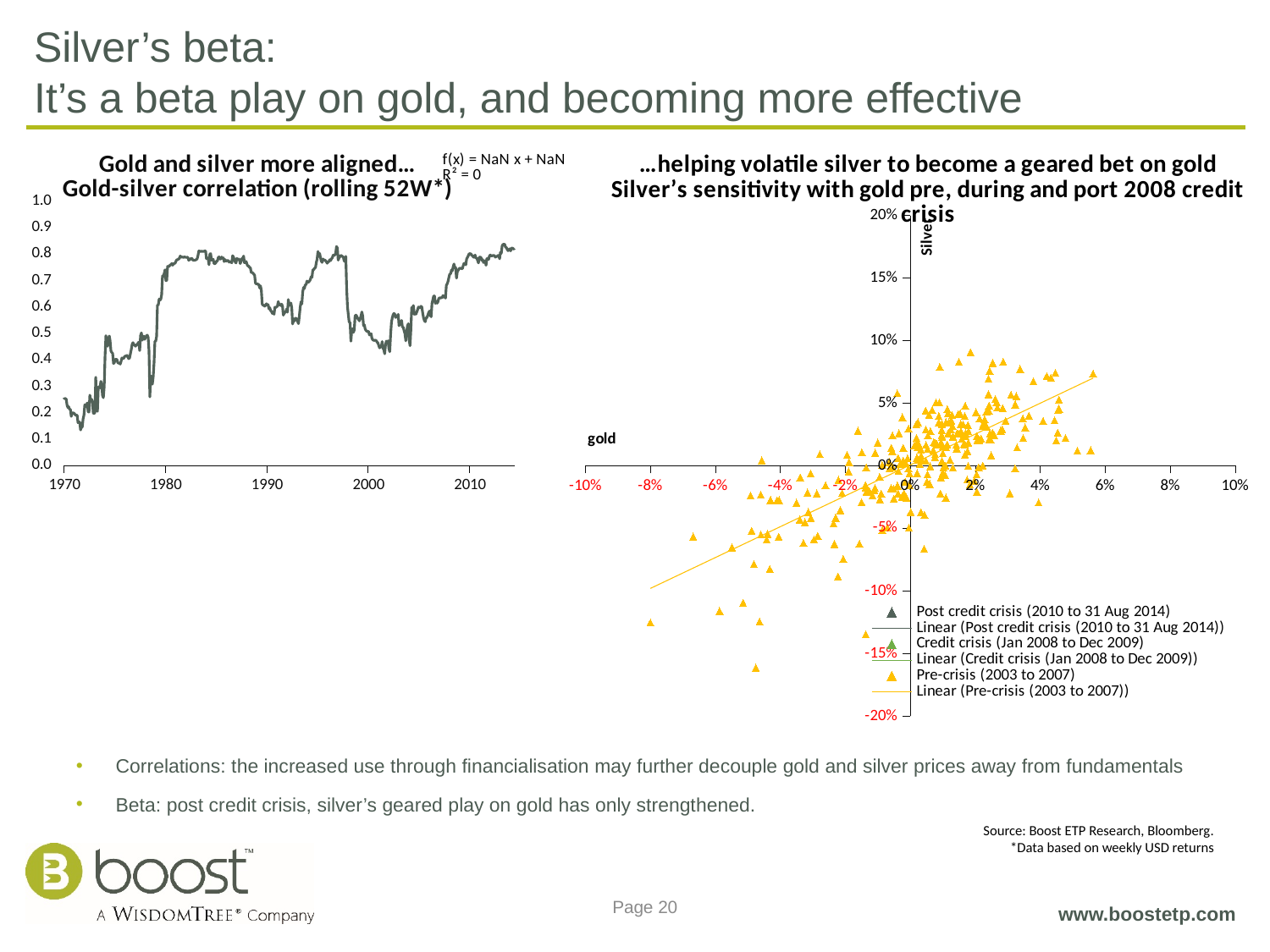
In the right chart (Silver's sensitivity with gold), do silver returns generally rise or fall as gold returns increase along the x axis? rise In the left chart (Gold-silver correlation), is the correlation value at 1970 greater or less than 0.5? less In the left chart (Gold-silver correlation), what is the earliest year labelled on the horizontal axis? 1970 In the right chart (Silver's sensitivity with gold), what is the maximum value labelled on the vertical (Silver) axis? 20% How many entries does the legend of the right chart (Silver's sensitivity with gold) list? 6 In the left chart (Gold-silver correlation), does the correlation overall rise or fall from 1970 to the end of the series? rise In the right chart (Silver's sensitivity with gold), which period does the legend entry "Pre-crisis" cover? 2003 to 2007 What kind of chart is the left chart titled "Gold-silver correlation (rolling 52W*)"? line chart What kind of chart is the right chart titled "Silver's sensitivity with gold pre, during and port 2008 credit crisis"? scatter chart In the left chart (Gold-silver correlation), is the correlation value at the end of the series (around 2014) greater or less than 0.5? greater